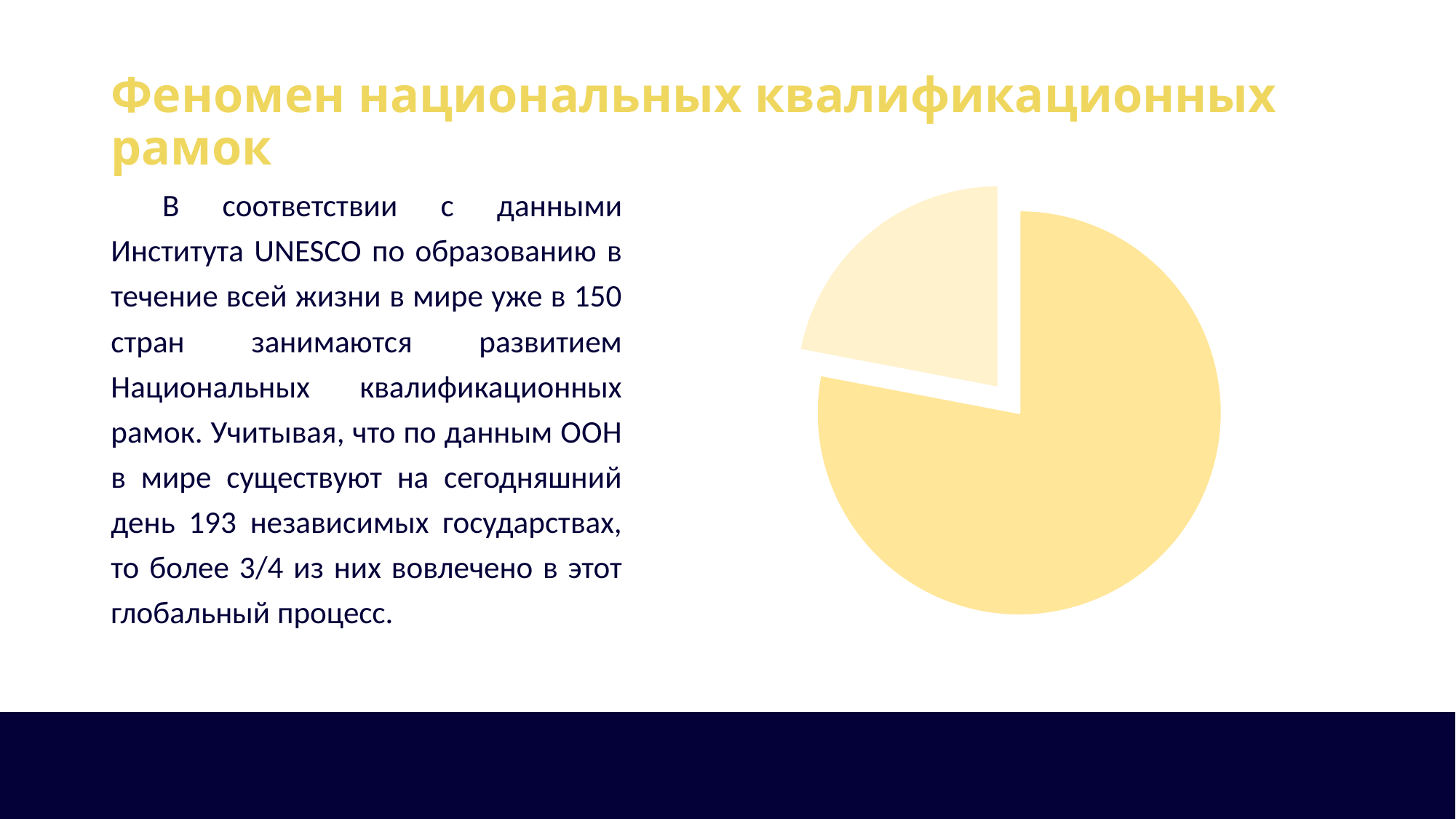
Is the smaller slice of the pie chart pulled out (exploded) from the rest of the pie? yes Which slice of the pie chart is larger, the darker yellow slice or the lighter pale yellow slice? the darker yellow slice Which slice of the pie chart is the largest? the darker yellow slice How many slices does the pie chart have? 2 Which slice of the pie chart is the smallest? the lighter pale yellow slice Does the pie chart display a legend? no What kind of chart is shown on the right side of the slide? pie chart